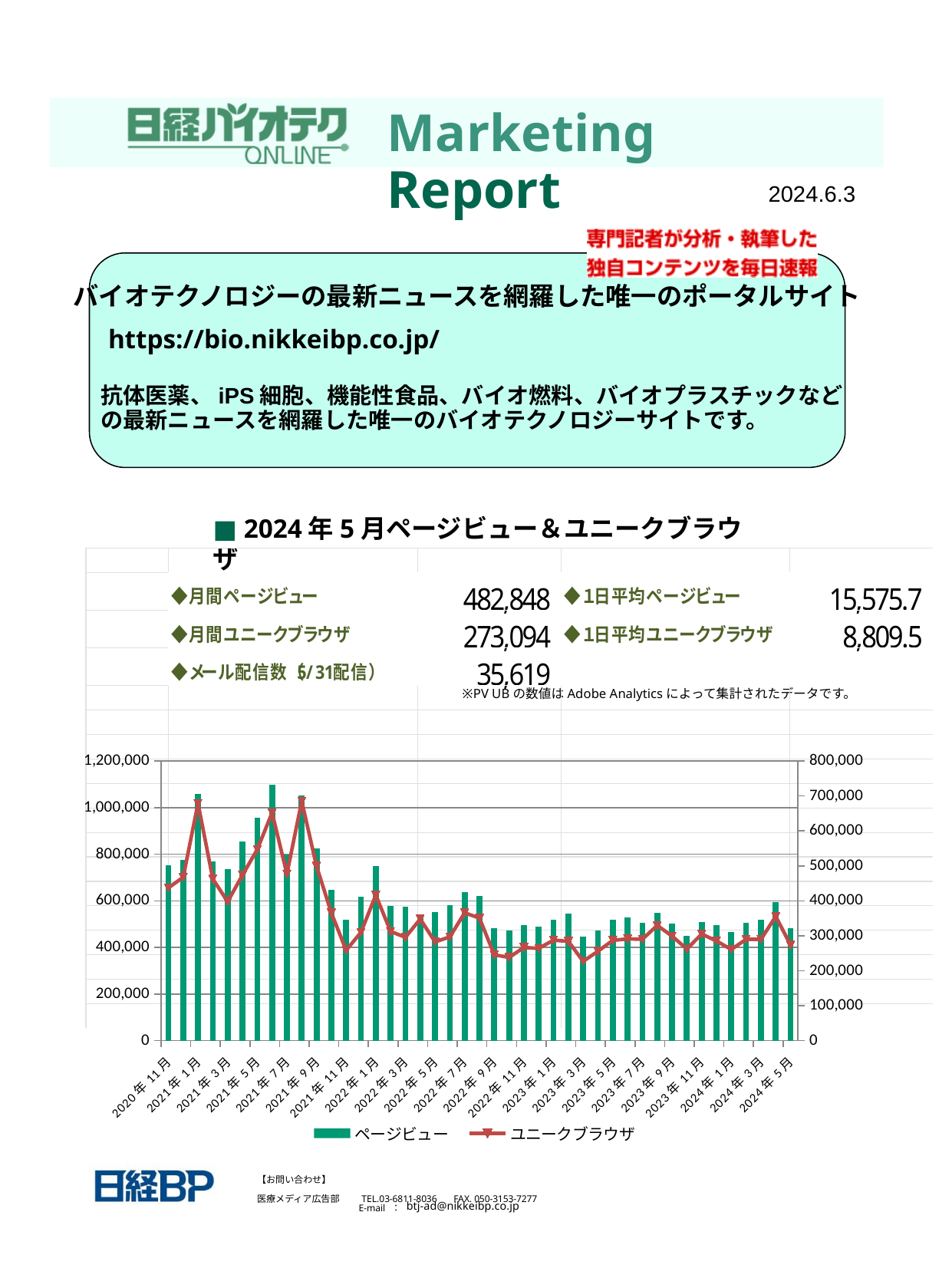
Overall, do the ページビュー values rise or fall from 2020年11月 to 2024年5月? fall Which series is drawn as bars in the chart? ページビュー Is the ユニークブラウザ value for 2021年1月 greater or less than 600,000 on the right axis? greater Which has the larger ページビュー value, 2020年11月 or 2024年5月? 2020年11月 Is the ページビュー value for 2020年11月 greater or less than 600,000? greater Which has the larger ユニークブラウザ value, 2021年1月 or 2023年1月? 2021年1月 How many series does the chart legend list? 2 Is the ページビュー value for 2024年5月 greater or less than 600,000? less Which series is drawn as a line in the chart? ユニークブラウザ What kind of chart is shown on the slide? A combined bar and line chart